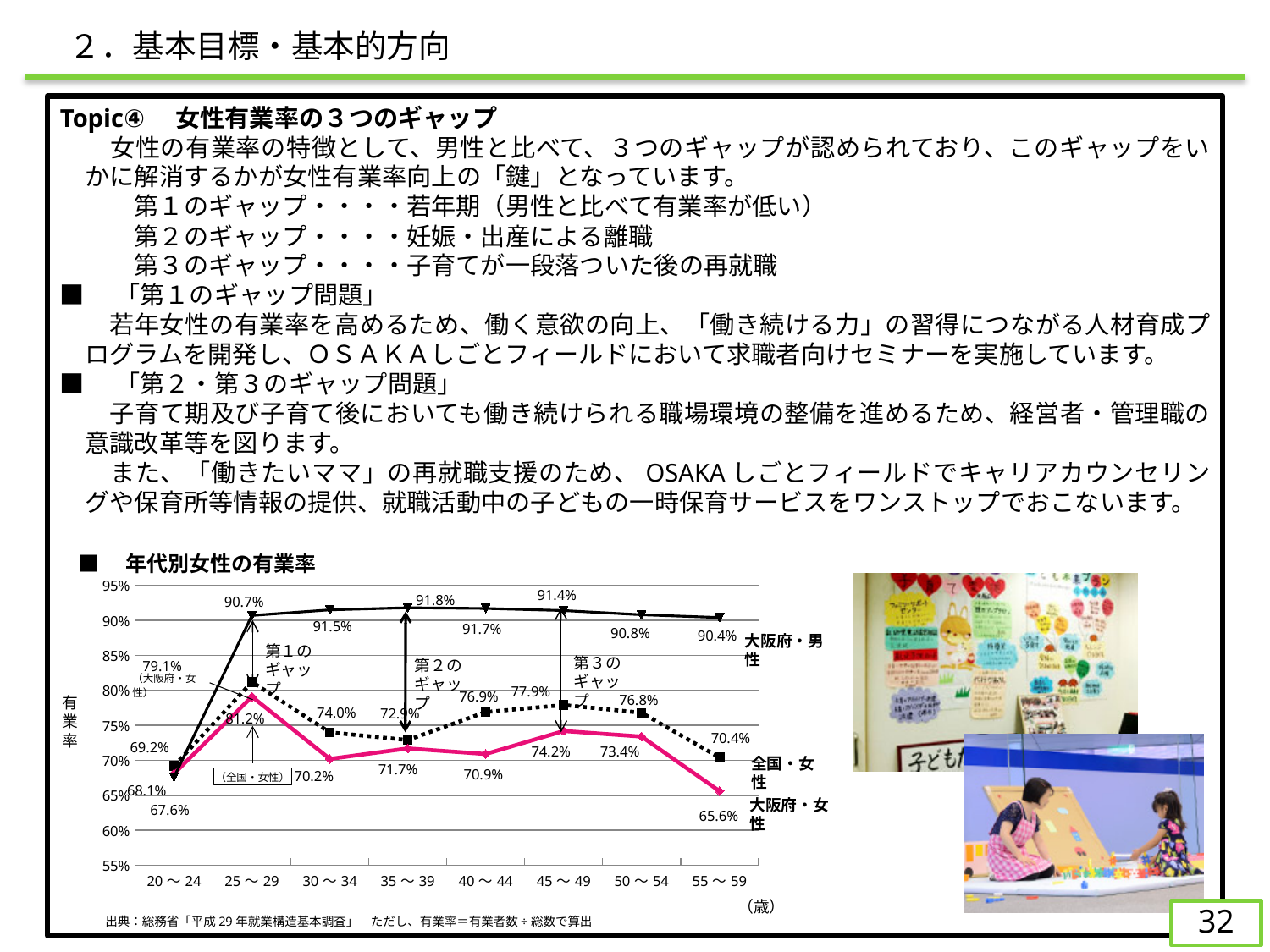
In which age group is the value for 大阪府・女性 lowest? 55～59 How many series does the legend of the 年代別女性の有業率 chart list? 3 What is the value for 全国・女性 in the 40～44 age group? 76.9% In the 40～44 age group, which is larger: 全国・女性 or 大阪府・女性? 全国・女性 Is the value for 大阪府・女性 in the 55～59 age group greater or less than 70%? less What is the value for 大阪府・女性 in the 45～49 age group? 74.2% What is the difference between 全国・女性 and 大阪府・女性 in the 25～29 age group? 2.1 percentage points What kind of chart is used to show 年代別女性の有業率? Line chart Which source is cited below the 年代別女性の有業率 chart? 総務省「平成29年就業構造基本調査」 What is the value for 大阪府・男性 in the 20～24 age group? 68.1% In which age group is the value for 全国・女性 highest? 25～29 How many age groups are plotted along the x axis of the 年代別女性の有業率 chart? 8